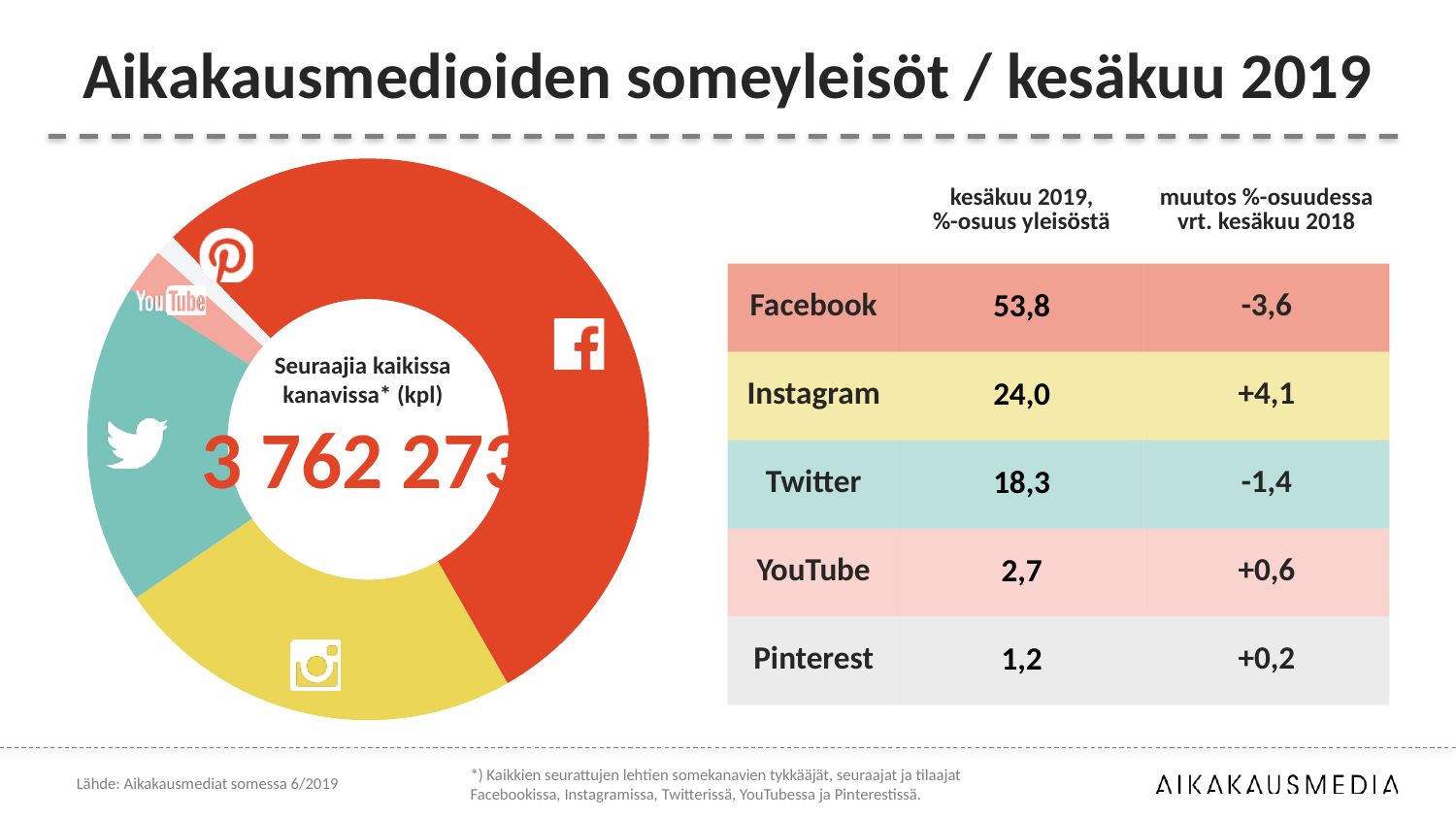
According to the table, what is Facebook's share of the audience in June 2019? 53,8 Which channel's share of the audience changed the most compared with June 2018, according to the table? Instagram Which channel has the largest slice of the donut chart? Facebook How many channels are shown as slices in the donut chart? 5 What kind of chart is shown on the left of the slide? Donut (pie) chart According to the table, what is Twitter's share of the audience in June 2019? 18,3 What is the change in YouTube's share of the audience compared with June 2018? +0,6 Which is larger in June 2019: Twitter's share or YouTube's share? Twitter Which channel has the smallest slice of the donut chart? Pinterest What is the difference between Facebook's and Instagram's shares of the audience in June 2019? 29,8 According to the table, what is Instagram's share of the audience in June 2019? 24,0 What total number of followers across all channels is shown in the centre of the donut chart? 3 762 273